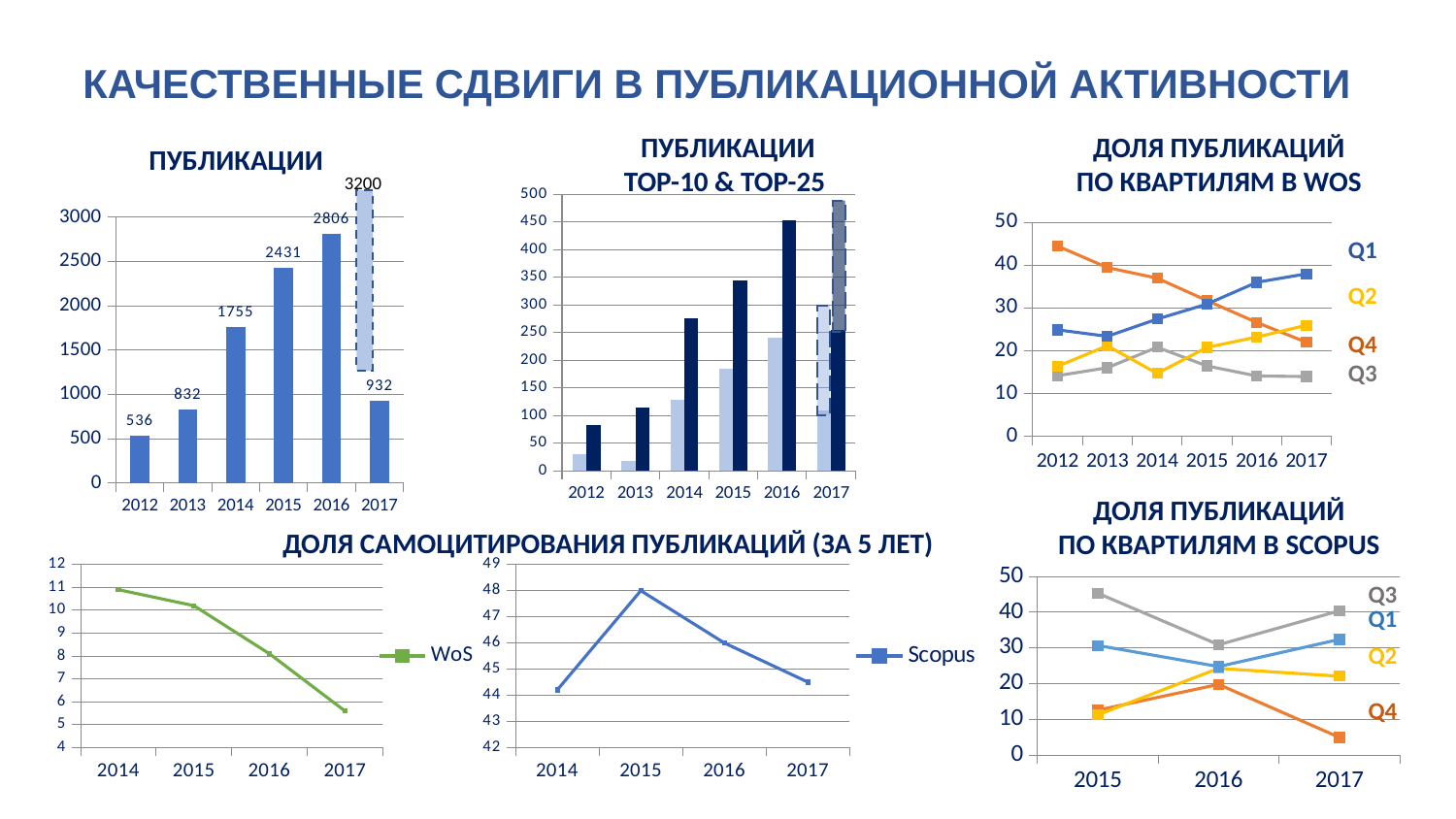
How many quartile series are plotted in the ДОЛЯ ПУБЛИКАЦИЙ ПО КВАРТИЛЯМ В SCOPUS chart? 4 In the ПУБЛИКАЦИИ bar chart, what is the difference between the values for 2016 and 2015? 375 In the ДОЛЯ ПУБЛИКАЦИЙ ПО КВАРТИЛЯМ В WOS chart, does the Q1 line rise or fall from 2012 to 2017? rise In the ПУБЛИКАЦИИ bar chart, which year has the lowest value? 2012 In the ДОЛЯ САМОЦИТИРОВАНИЯ ПУБЛИКАЦИЙ (ЗА 5 ЛЕТ) chart, does the WoS line rise or fall from 2014 to 2017? fall What kind of chart is the ПУБЛИКАЦИИ TOP-10 & TOP-25 chart? bar chart In the ПУБЛИКАЦИИ bar chart, which is larger, the value for 2014 or the value for 2017? 2014 In the ДОЛЯ ПУБЛИКАЦИЙ ПО КВАРТИЛЯМ В WOS chart, which quartile has the highest value in 2012? Q4 In the ПУБЛИКАЦИИ bar chart, what is the value for 2015? 2431 In the ДОЛЯ ПУБЛИКАЦИЙ ПО КВАРТИЛЯМ В SCOPUS chart, is the value for Q4 in 2017 greater or less than 10? less In the ПУБЛИКАЦИИ TOP-10 & TOP-25 chart, is the dark blue bar for 2016 greater or less than 400? greater How many years are shown on the x axis of the ПУБЛИКАЦИИ bar chart? 6